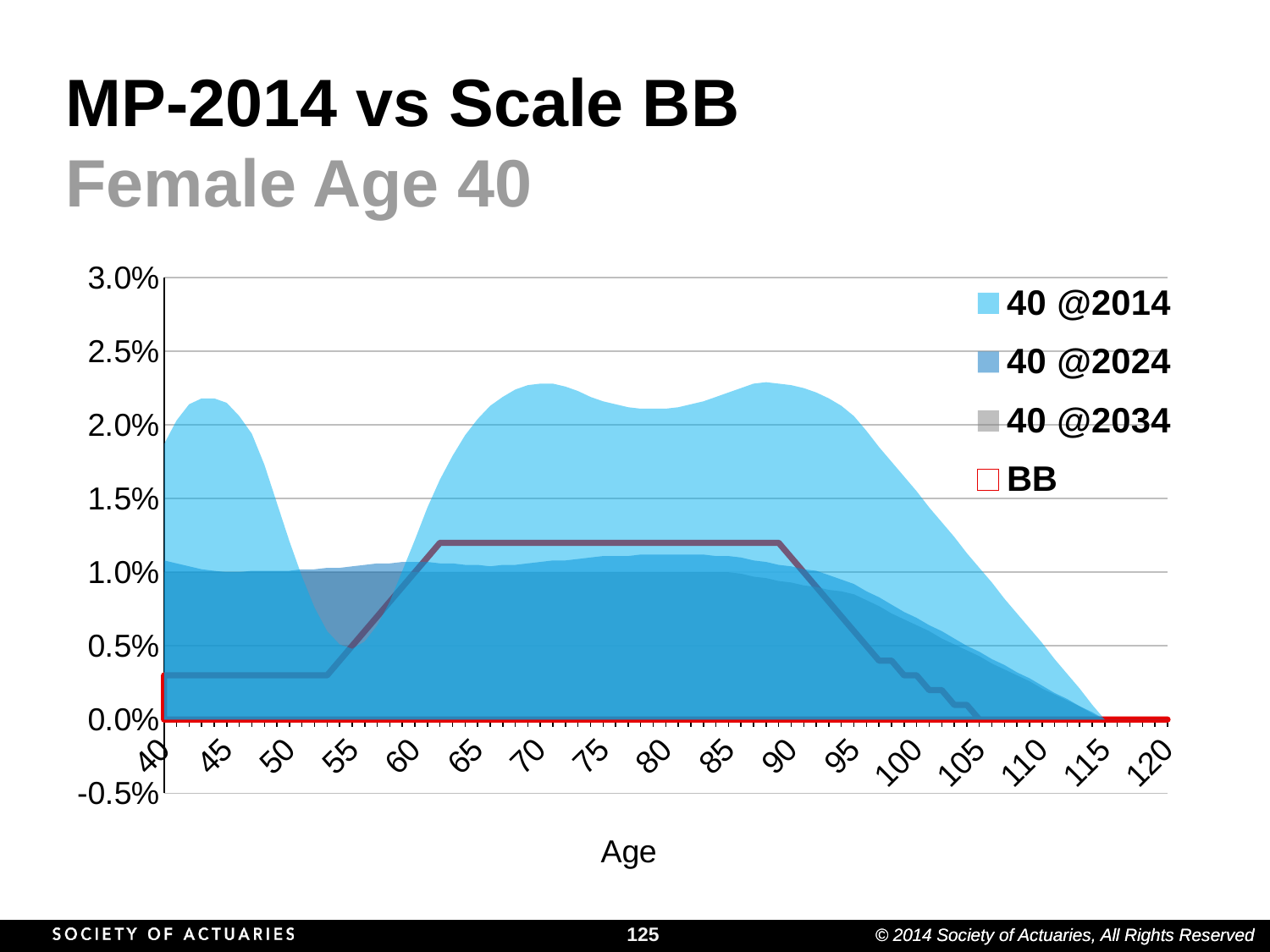
At age 70, which is larger: the 40 @2014 series or the 40 @2024 series? 40 @2014 What is the subtitle of the chart slide below 'MP-2014 vs Scale BB'? Female Age 40 What kind of chart is shown on the slide? Area chart What is the label of the x axis? Age At age 55, which is larger: the BB line or the 40 @2024 series? 40 @2024 How many series does the legend list? 4 Does the BB line rise or fall between age 55 and age 63? rise Is the value of the 40 @2014 series at age 70 greater or less than 2.0%? greater Is the value of the BB line at age 45 greater or less than 0.5%? less Is the value of the BB line at age 75 greater or less than 1.0%? greater Does the 40 @2014 series rise or fall between age 95 and age 115? fall